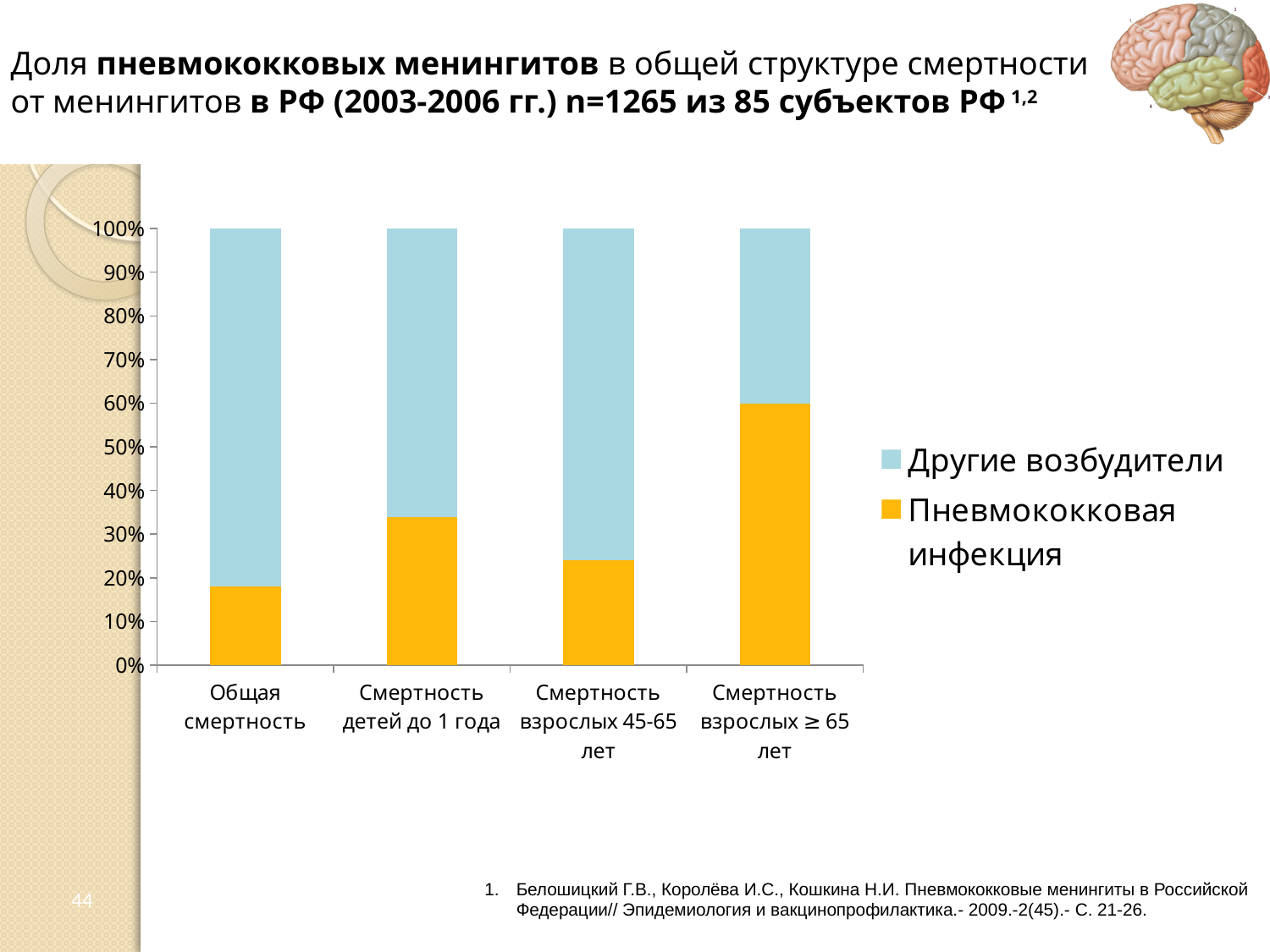
Which has a larger share of Другие возбудители: Общая смертность or Смертность взрослых ≥ 65 лет? Общая смертность How many series does the chart legend list? 2 What colour represents Пневмококковая инфекция in the chart? Orange (yellow-orange) Is the share of Пневмококковая инфекция for Смертность взрослых ≥ 65 лет greater or less than 50%? greater Which category has the lowest share of Пневмококковая инфекция? Общая смертность Which has a larger share of Пневмококковая инфекция: Смертность детей до 1 года or Смертность взрослых 45-65 лет? Смертность детей до 1 года Is the share of Пневмококковая инфекция for Общая смертность greater or less than 30%? less Is the share of Пневмококковая инфекция for Смертность детей до 1 года greater or less than 30%? greater How many categories are shown on the x axis of the chart? 4 What kind of chart is shown on the slide? Stacked bar chart Which category has the highest share of Пневмококковая инфекция? Смертность взрослых ≥ 65 лет